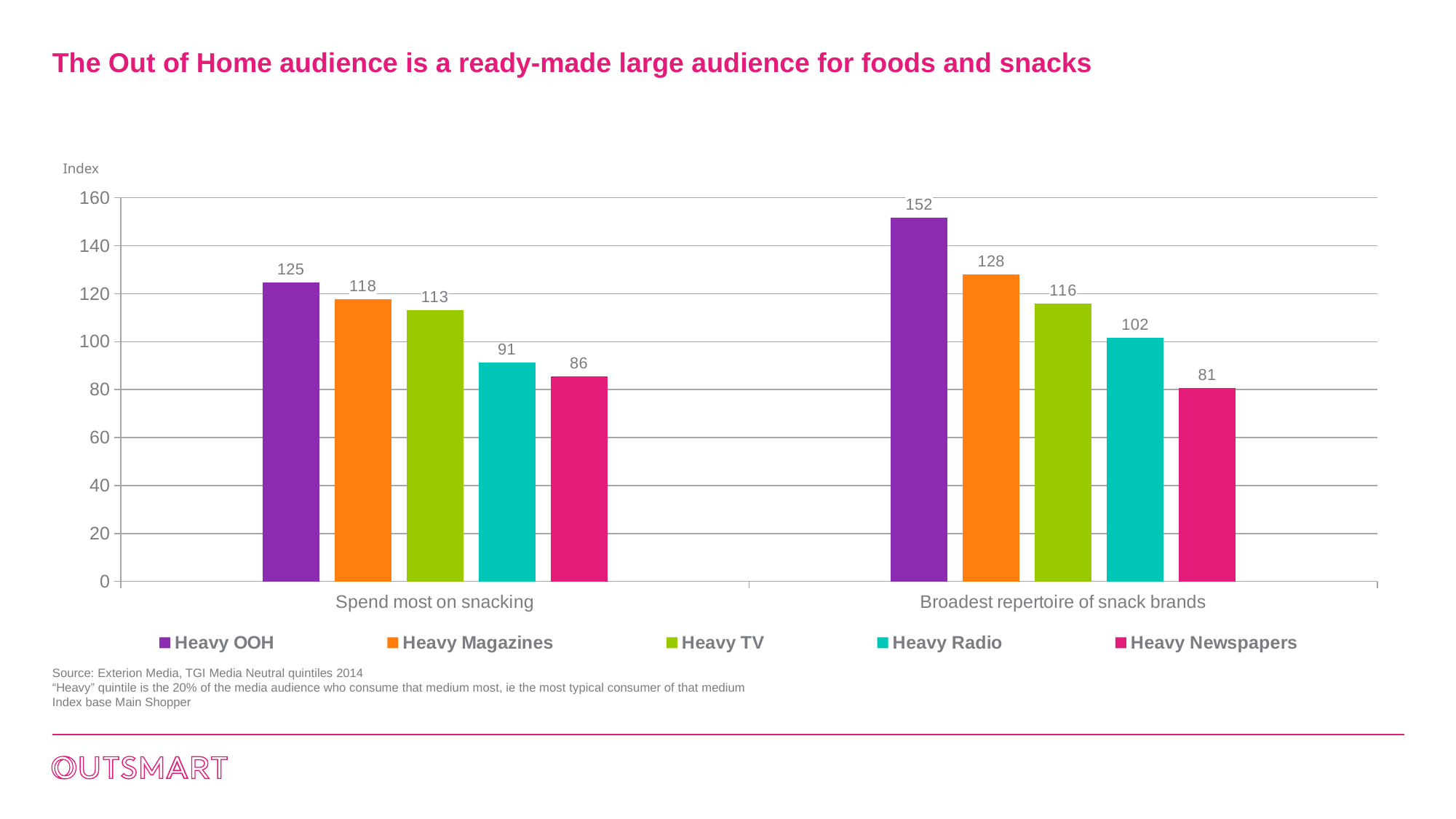
Which series has the highest index in the 'Broadest repertoire of snack brands' category? Heavy OOH Is the Heavy OOH index for 'Broadest repertoire of snack brands' greater or less than 140? greater How many categories are shown on the x axis? 2 What is the index value for Heavy Newspapers in the 'Broadest repertoire of snack brands' category? 81 How many series does the legend list? 5 What is the difference between the Heavy OOH and Heavy Magazines index values in the 'Broadest repertoire of snack brands' category? 24 Which series has the lowest index in the 'Spend most on snacking' category? Heavy Newspapers What is the index value for Heavy OOH in the 'Spend most on snacking' category? 125 What kind of chart is shown on the slide? Bar chart What is the index value for Heavy Radio in the 'Spend most on snacking' category? 91 Which is larger: the Heavy Magazines index for 'Spend most on snacking' or the Heavy TV index for 'Broadest repertoire of snack brands'? Heavy Magazines for 'Spend most on snacking' What is the difference between the Heavy TV and Heavy Radio index values in the 'Spend most on snacking' category? 22